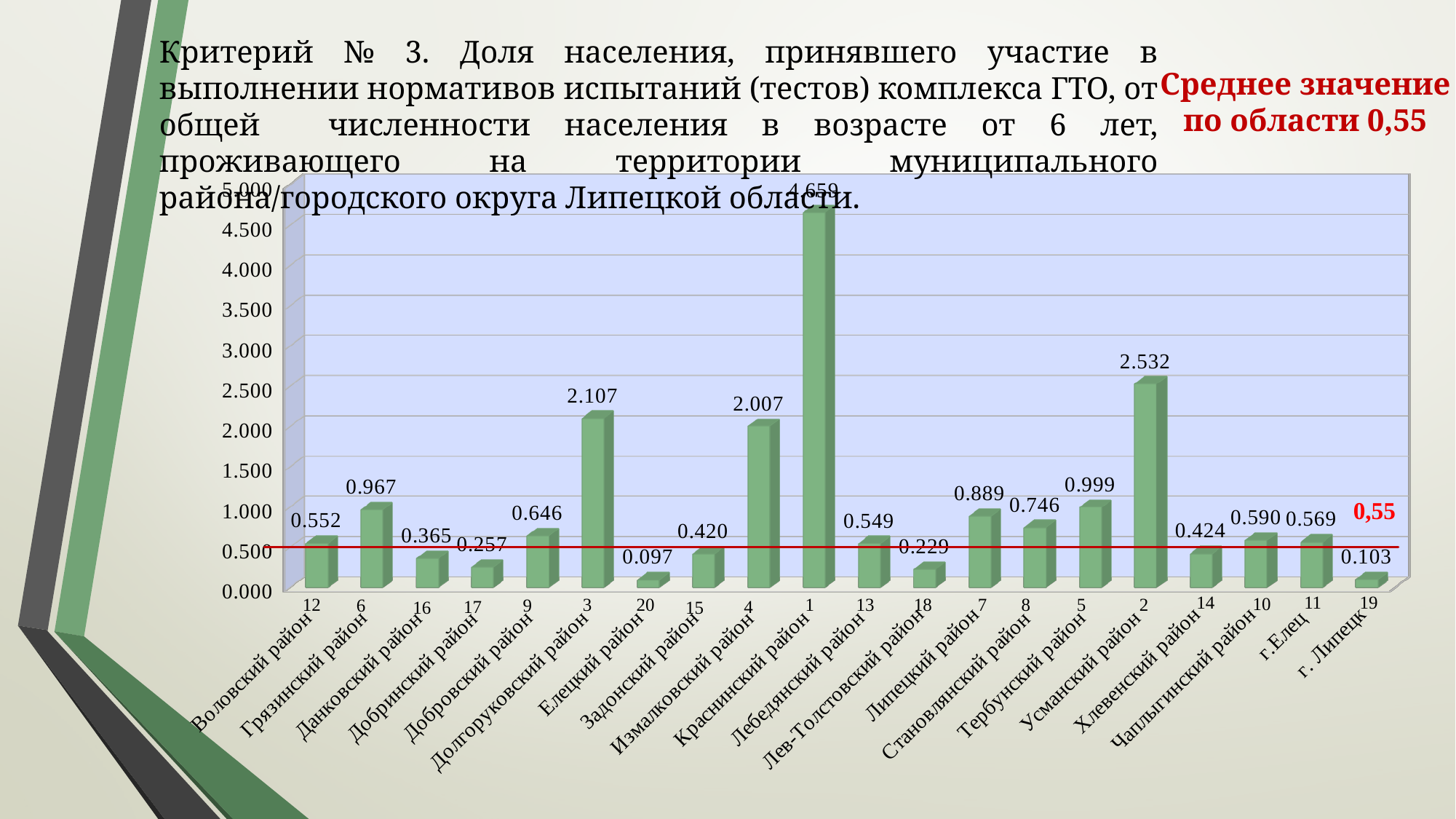
Which has a larger value, Липецкий район or Становлянский район? Липецкий район What is the difference between the values for Усманский район and Измалковский район? 0.525 How many districts (categories) are shown in the chart? 20 What is the value for Долгоруковский район? 2.107 What is the regional average value marked by the red line on the chart? 0,55 What type of chart is shown on the slide? bar chart Which district has the lowest value in the chart? Елецкий район What is the value for Усманский район? 2.532 What is the value for Грязинский район? 0.967 Which district has the highest value in the chart? Краснинский район Is the value for Тербунский район greater or less than 0.500? greater What is the value for г. Липецк? 0.103